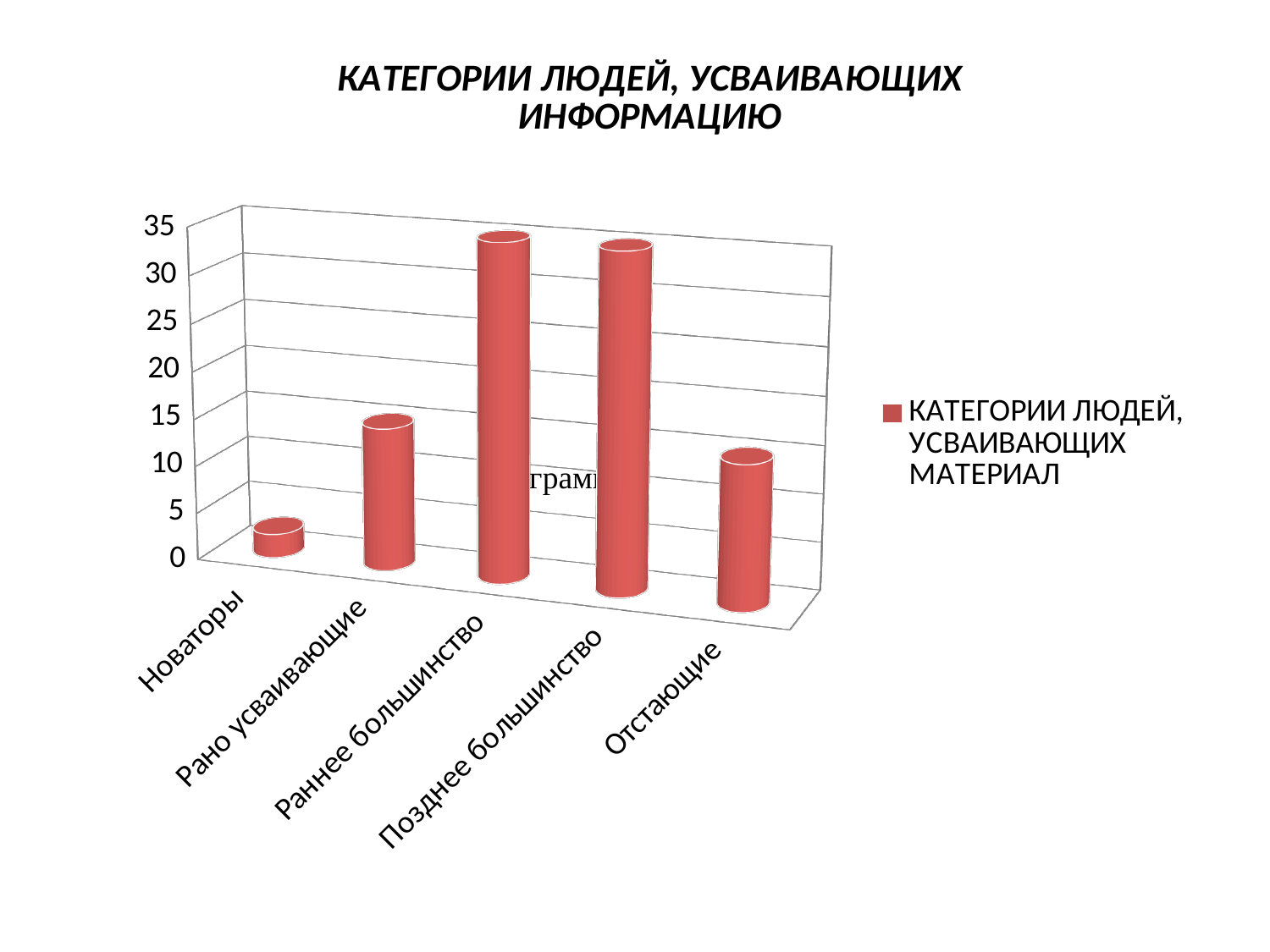
How many series does the chart's legend list? 1 What kind of chart is shown on the slide? bar chart Which is larger, the value for Отстающие or the value for Новаторы? Отстающие Which is larger, the value for Раннее большинство or the value for Рано усваивающие? Раннее большинство What is the series name shown in the chart's legend? КАТЕГОРИИ ЛЮДЕЙ, УСВАИВАЮЩИХ МАТЕРИАЛ Which category has the lowest value in the chart? Новаторы Is the value for Рано усваивающие greater or less than 10? greater Is the value for Позднее большинство greater or less than 25? greater How many categories are shown on the x axis of the chart? 5 Is the value for Раннее большинство greater or less than 25? greater